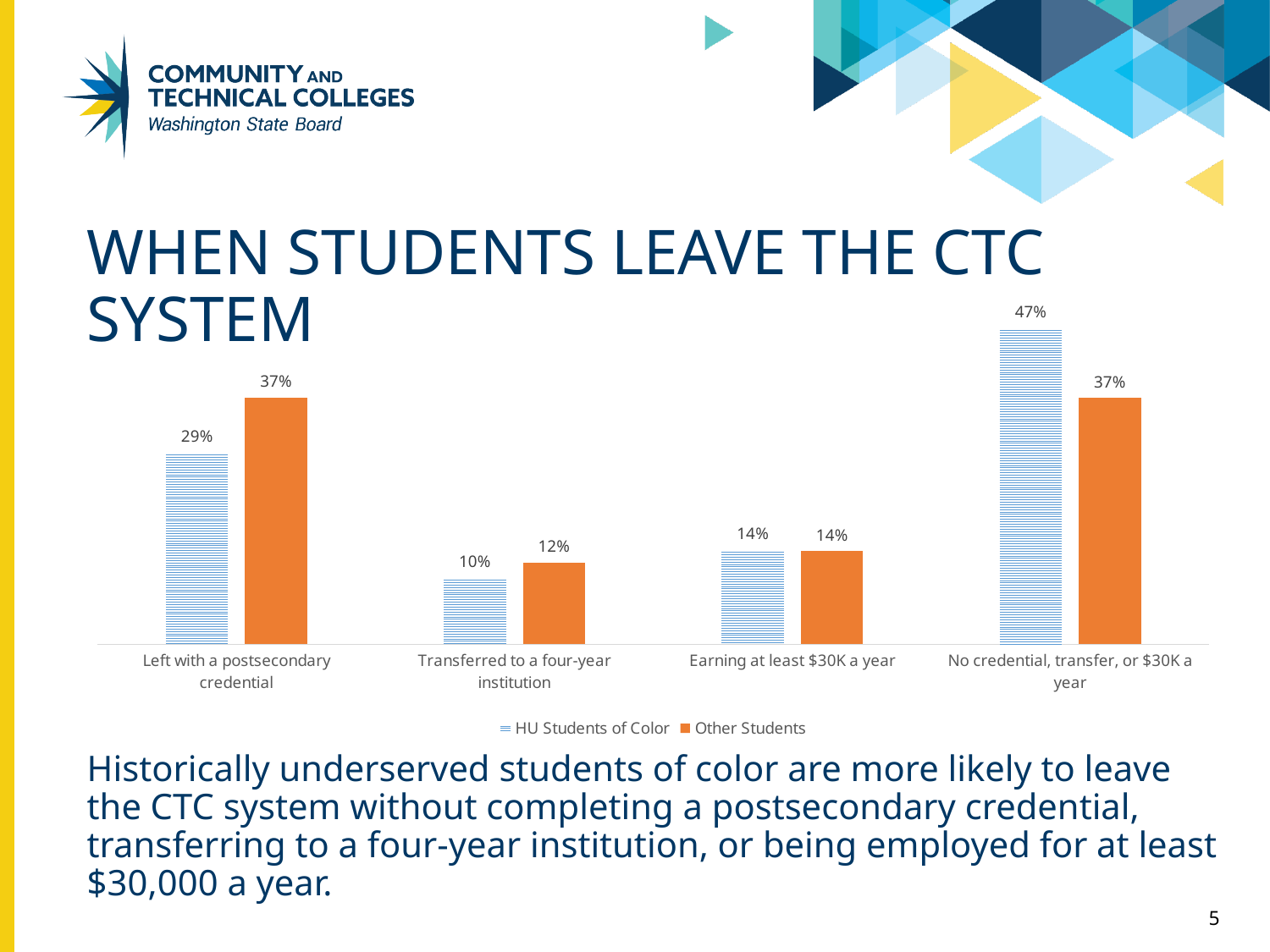
What is the difference between HU Students of Color and Other Students in the 'No credential, transfer, or $30K a year' category? 10% Which category has the highest value for HU Students of Color? No credential, transfer, or $30K a year Which group has the larger value for 'Transferred to a four-year institution'? Other Students What percentage of Other Students transferred to a four-year institution? 12% Which category has the lowest value for Other Students? Transferred to a four-year institution How many series does the legend list? 2 How many categories are shown on the x axis? 4 What percentage of HU Students of Color left with a postsecondary credential? 29% What is the value for Other Students in the 'Earning at least $30K a year' category? 14% What is the value for HU Students of Color in the 'No credential, transfer, or $30K a year' category? 47% What kind of chart is shown on the slide? Bar chart What is the difference between Other Students and HU Students of Color in the 'Left with a postsecondary credential' category? 8%